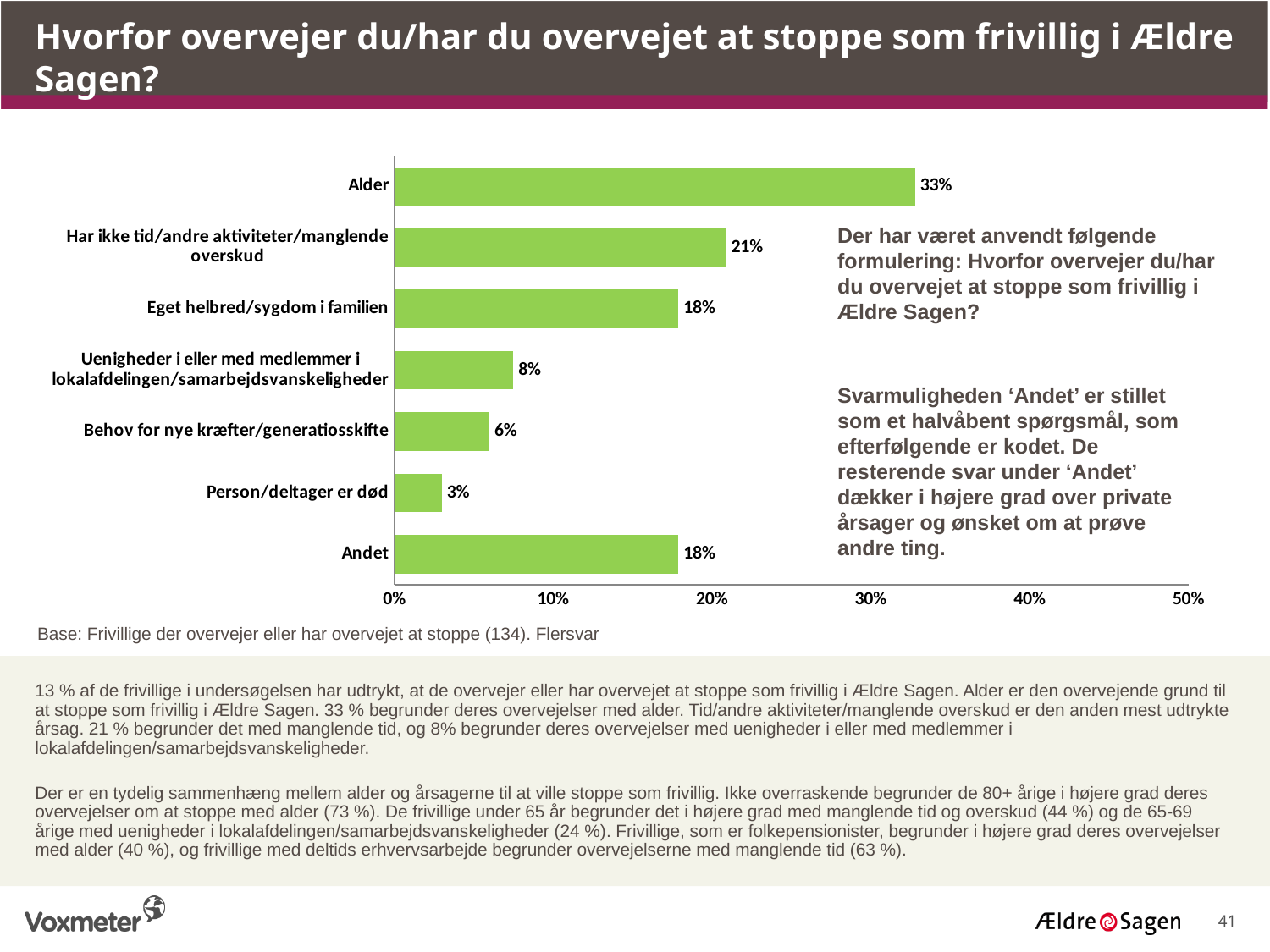
What kind of chart is shown on the slide? bar chart What is the value for Alder? 33% What is the value for Behov for nye kræfter/generatiosskifte? 6% What is the value for Har ikke tid/andre aktiviteter/manglende overskud? 21% Which is larger, the value for Uenigheder i eller med medlemmer i lokalafdelingen/samarbejdsvanskeligheder or the value for Andet? Andet What is the maximum value shown on the horizontal axis? 50% How many categories are shown in the chart? 7 Is the value for Alder greater or less than 30%? greater What is the difference between the values for Alder and Eget helbred/sygdom i familien? 15% What is the value for Person/deltager er død? 3% Which category has the highest value? Alder Which category has the lowest value? Person/deltager er død